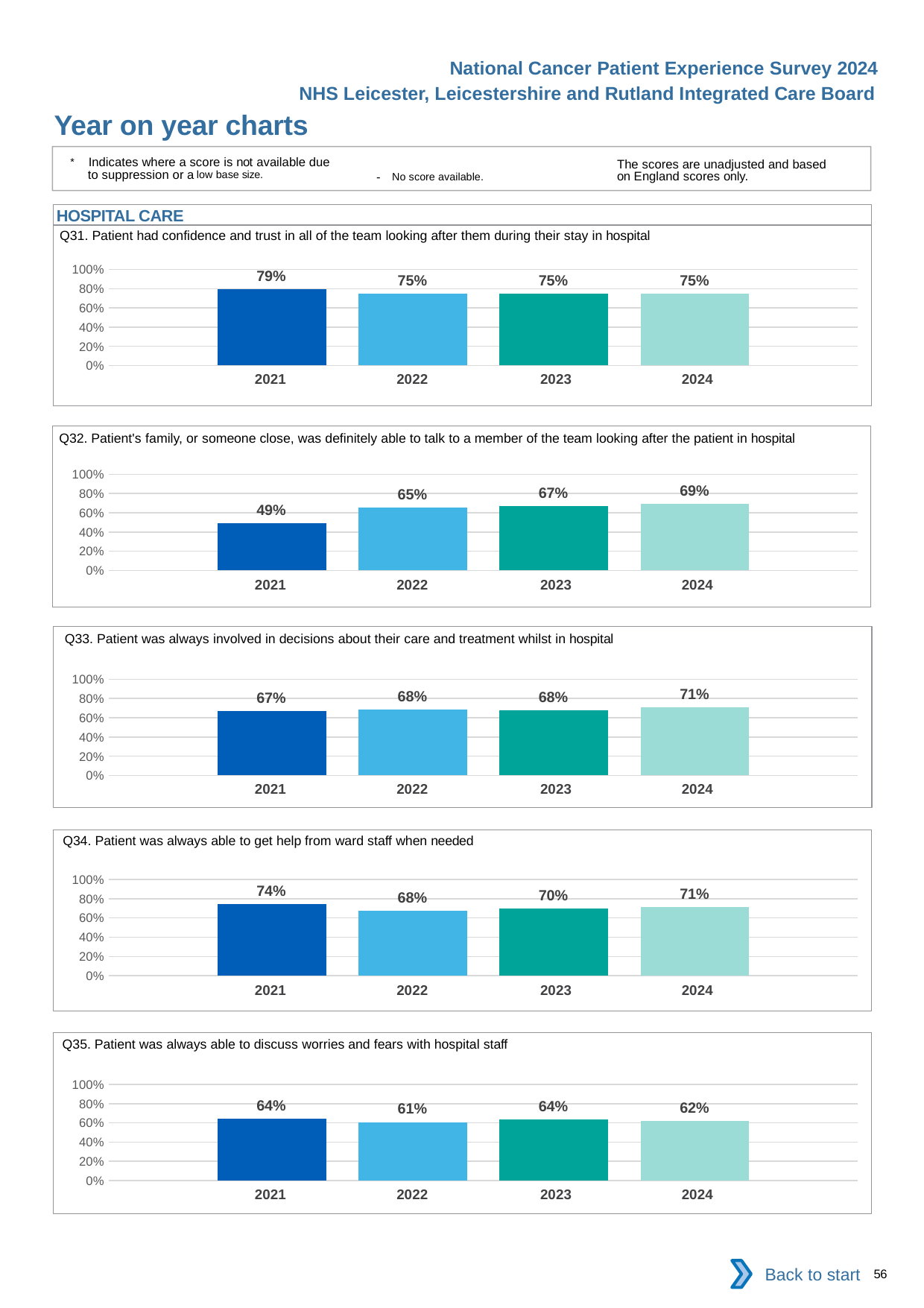
How many bars are shown in the Q33 chart? 4 What type of chart is the Q31 chart? bar chart In the Q35 chart, is the value for 2023 greater or less than 60%? greater In the Q32 chart, do the values rise or fall from 2021 to 2024? rise How many charts are shown on the slide? 5 In the Q32 chart, what is the difference between the 2024 and 2021 values? 20% In the Q35 chart, what is the value for 2022? 61% In the Q33 chart, which year has the highest value? 2024 In the Q34 chart, which is larger, the value for 2021 or the value for 2022? 2021 In the Q32 chart, which year has the lowest value? 2021 In the Q34 chart, what is the difference between the 2021 and 2022 values? 6% In the Q31 chart, what is the value for 2021? 79%